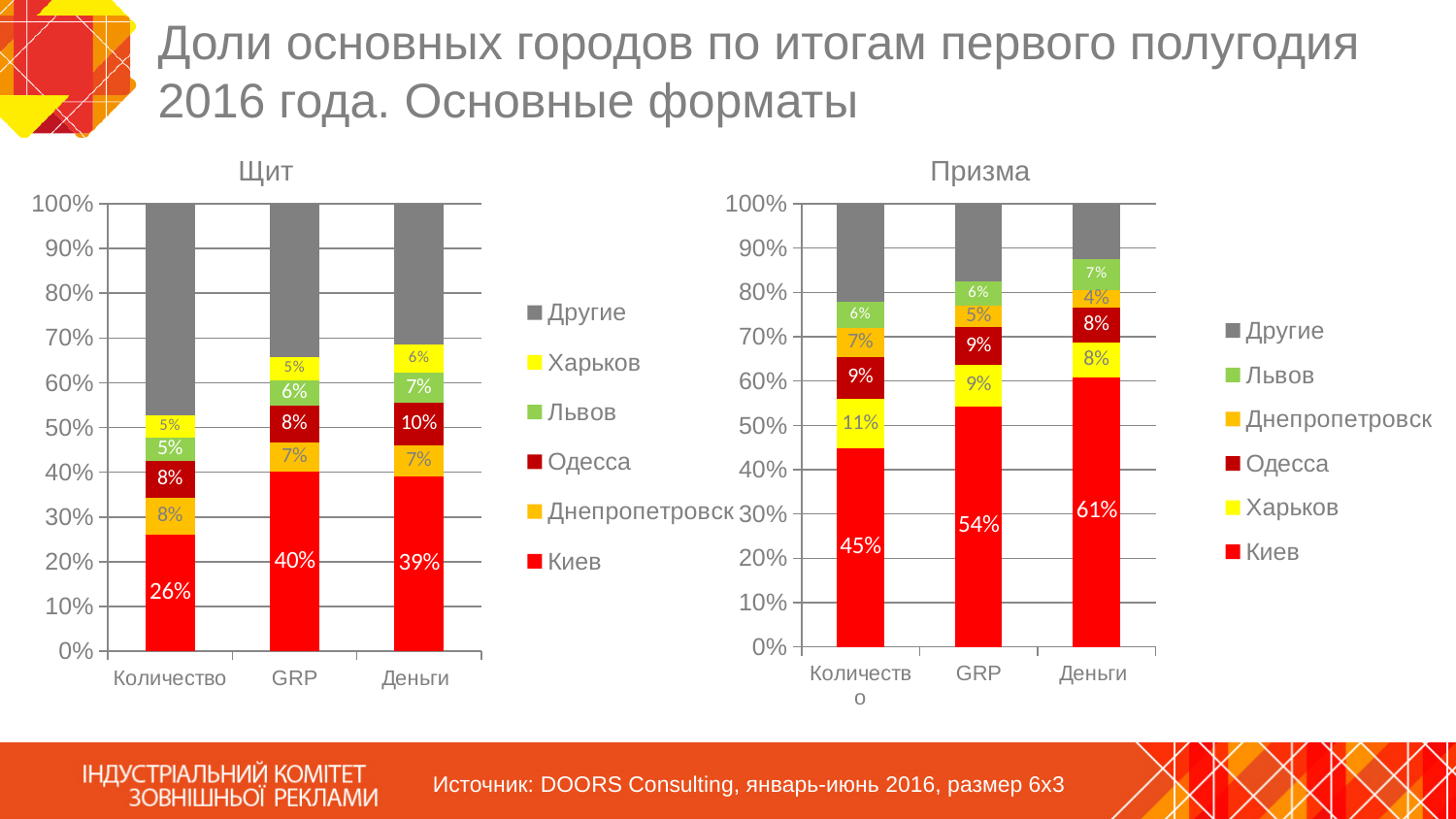
In the "Призма" chart, what is the difference between the Киев values for Деньги and Количество? 16% In the "Щит" chart, in which category is the Киев share the lowest? Количество Which is larger: the Киев value for Деньги in the "Щит" chart or the Киев value for Деньги in the "Призма" chart? Призма In the "Щит" chart, what is the value for Киев in the Количество category? 26% In the "Призма" chart, in which category is the Киев share the highest? Деньги In the "Щит" chart, what is the difference between the Киев values for GRP and Количество? 14% How many categories are shown on the x axis of the "Щит" chart? 3 In the "Призма" chart, what is the value for Харьков in the Количество category? 11% What type of chart is the "Щит" chart? Stacked bar chart In the "Щит" chart, what is the value for Одесса in the Деньги category? 10% How many series does the legend of the "Призма" chart list? 6 In the "Призма" chart, what is the value for Киев in the GRP category? 54%